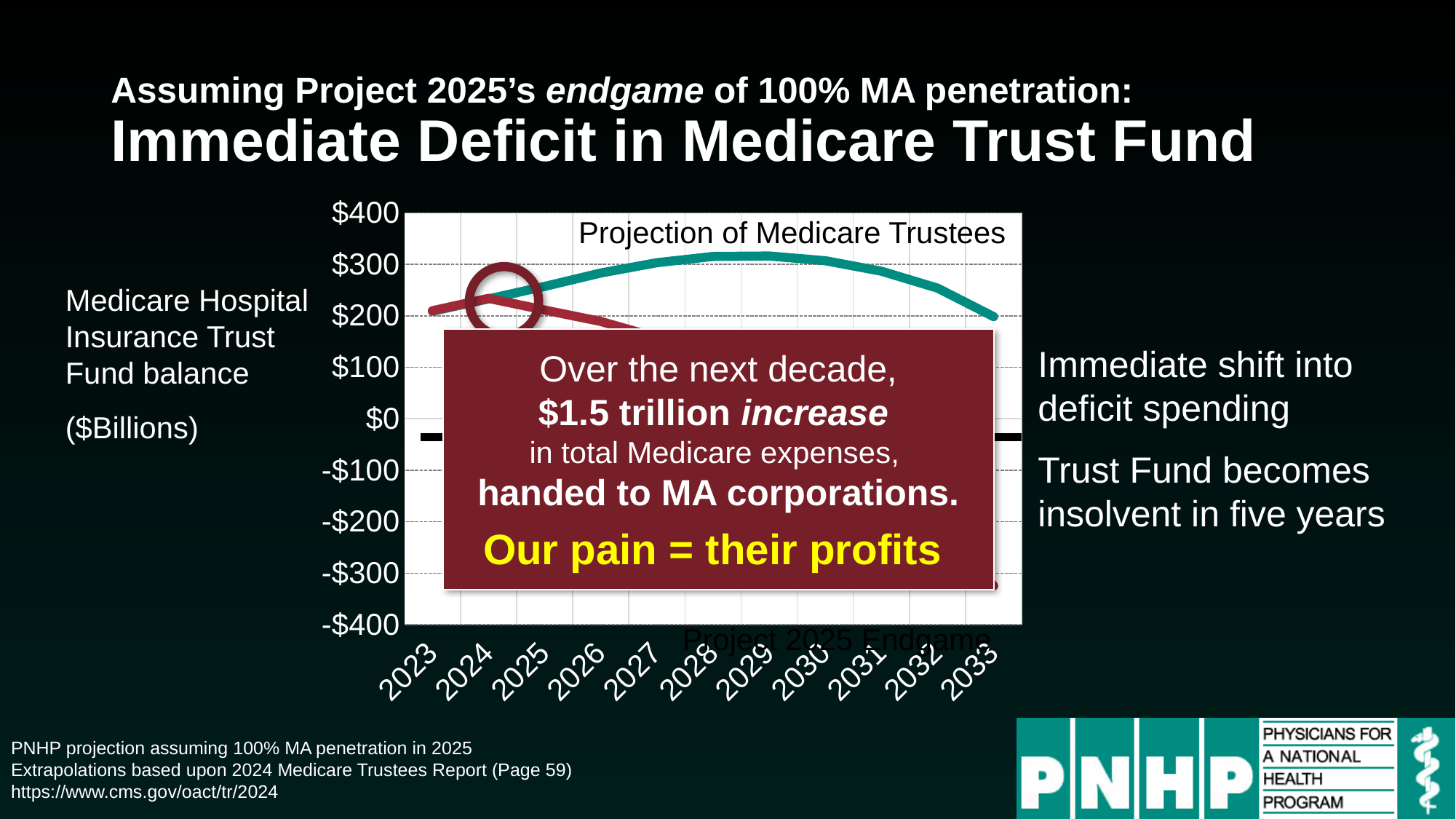
Does the Project 2025 Endgame line rise or fall from 2024 to 2027? Fall Is the Projection of Medicare Trustees value for 2028 greater or less than $200? greater How many years are labelled along the x axis of the chart? 11 What is the last year shown on the x axis? 2033 What kind of chart is shown on the slide? Line chart In 2028, which series is higher: Projection of Medicare Trustees or Project 2025 Endgame? Projection of Medicare Trustees What is the first year shown on the x axis? 2023 Does the Projection of Medicare Trustees line rise or fall from 2023 to 2028? Rise How many series are plotted on the chart? 2 Is the Projection of Medicare Trustees value for 2033 greater or less than $100? greater What is the highest value shown on the y axis? $400 Is the Projection of Medicare Trustees value for 2023 greater or less than $300? less